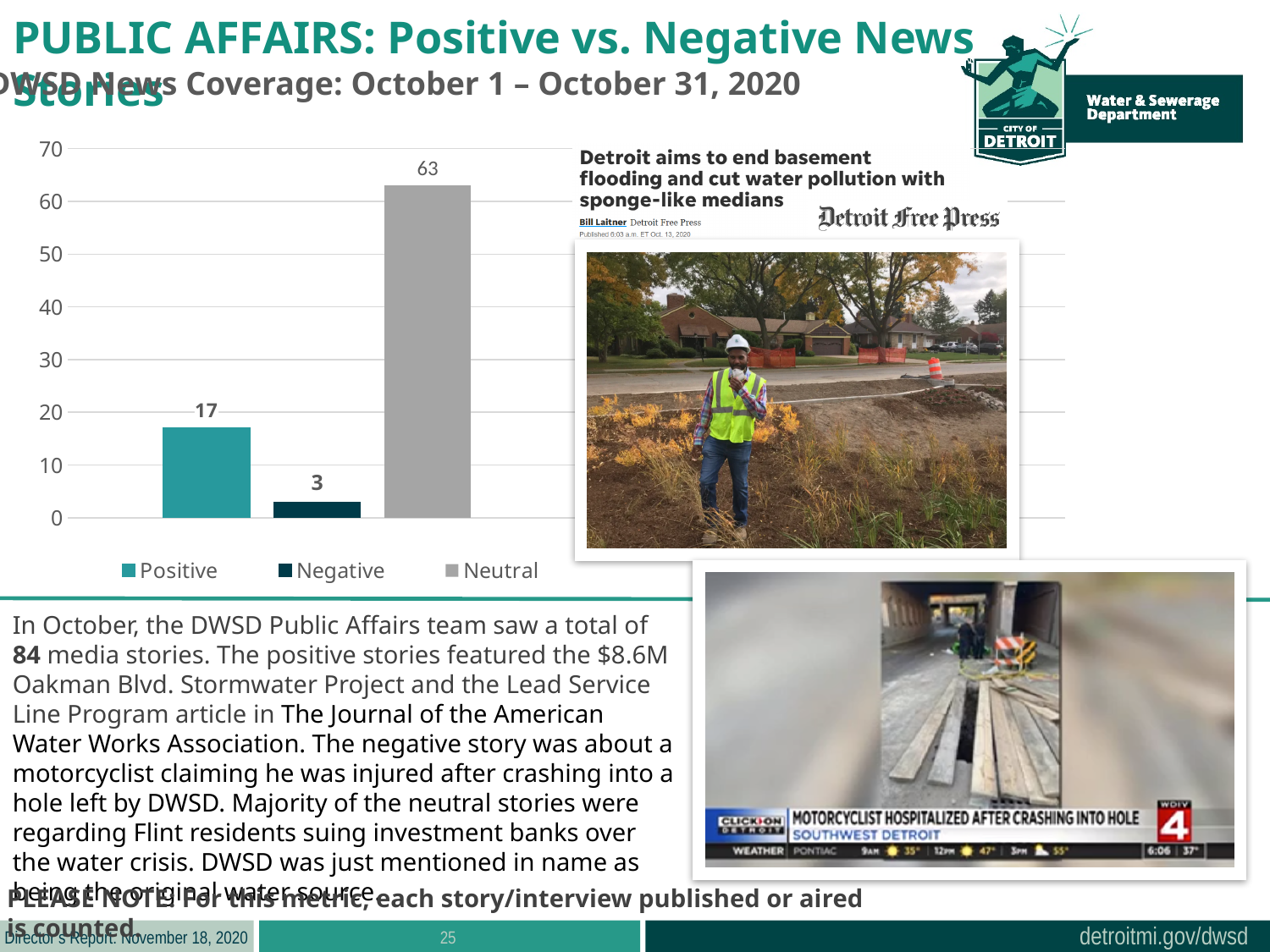
Is the value for Neutral greater or less than 60? greater What is the value for Negative news stories? 3 Which category has the lowest value? Negative How many entries does the chart legend list? 3 What is the value for Neutral news stories? 63 How many categories are shown in the chart? 3 What is the difference between the Neutral and Positive values? 46 Which is larger, the value for Positive or the value for Negative? Positive What kind of chart is shown on the slide? Bar chart Which category has the highest value? Neutral What is the value for Positive news stories? 17 What is the difference between the Positive and Negative values? 14